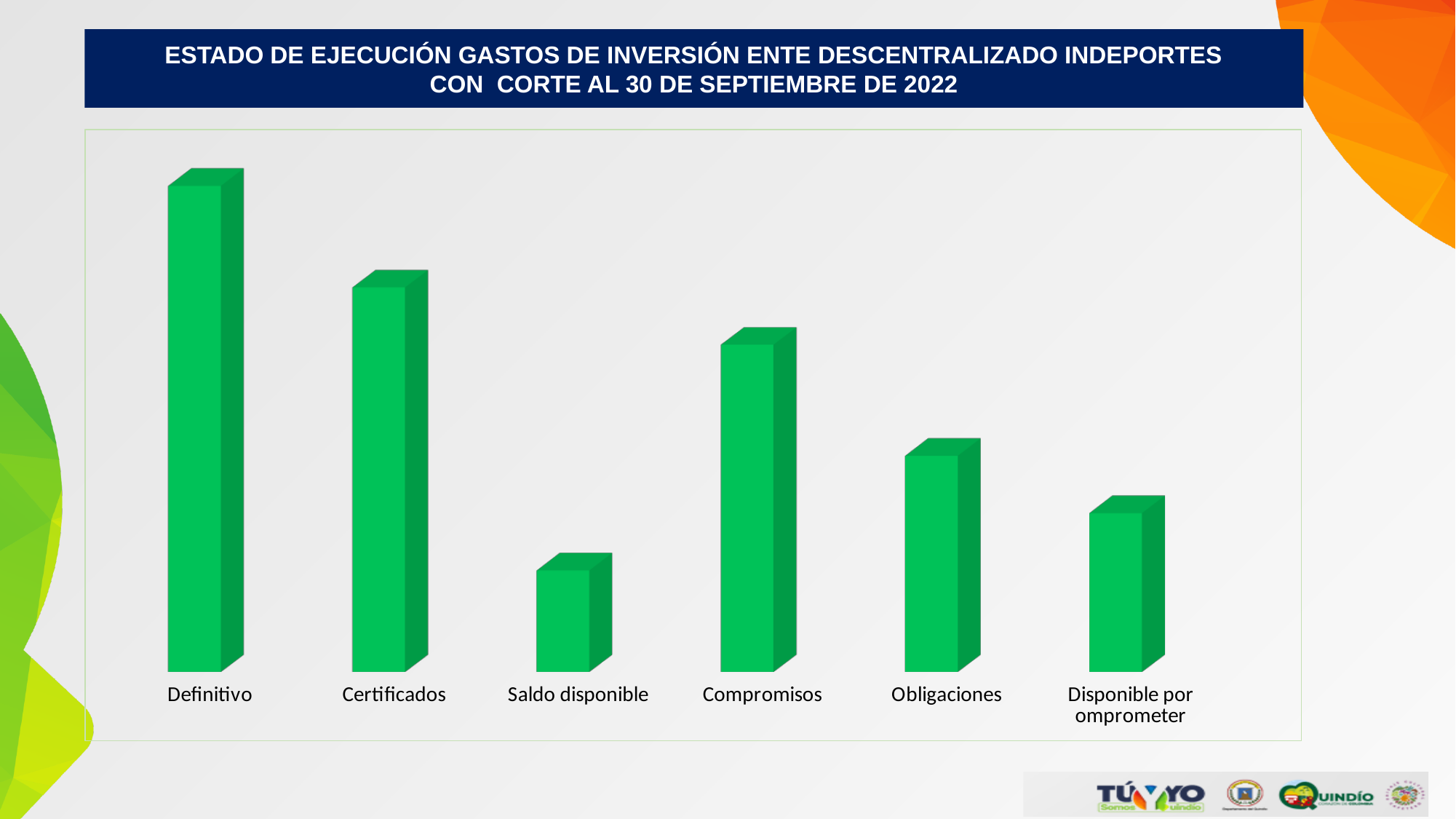
Which category is plotted immediately to the right of Saldo disponible? Compromisos Which category has the highest bar in the chart? Definitivo How many categories are plotted in the chart? 6 Which is larger, the value for Compromisos or the value for Obligaciones? Compromisos Which is larger, the value for Certificados or the value for Compromisos? Certificados Which category has the lowest bar in the chart? Saldo disponible What colour are the bars in the chart? Green Which is larger, the value for Saldo disponible or the value for Disponible por omprometer? Disponible por omprometer Do the values rise or fall across the first three categories, from Definitivo to Saldo disponible? Fall What kind of chart is shown on the slide? Bar chart